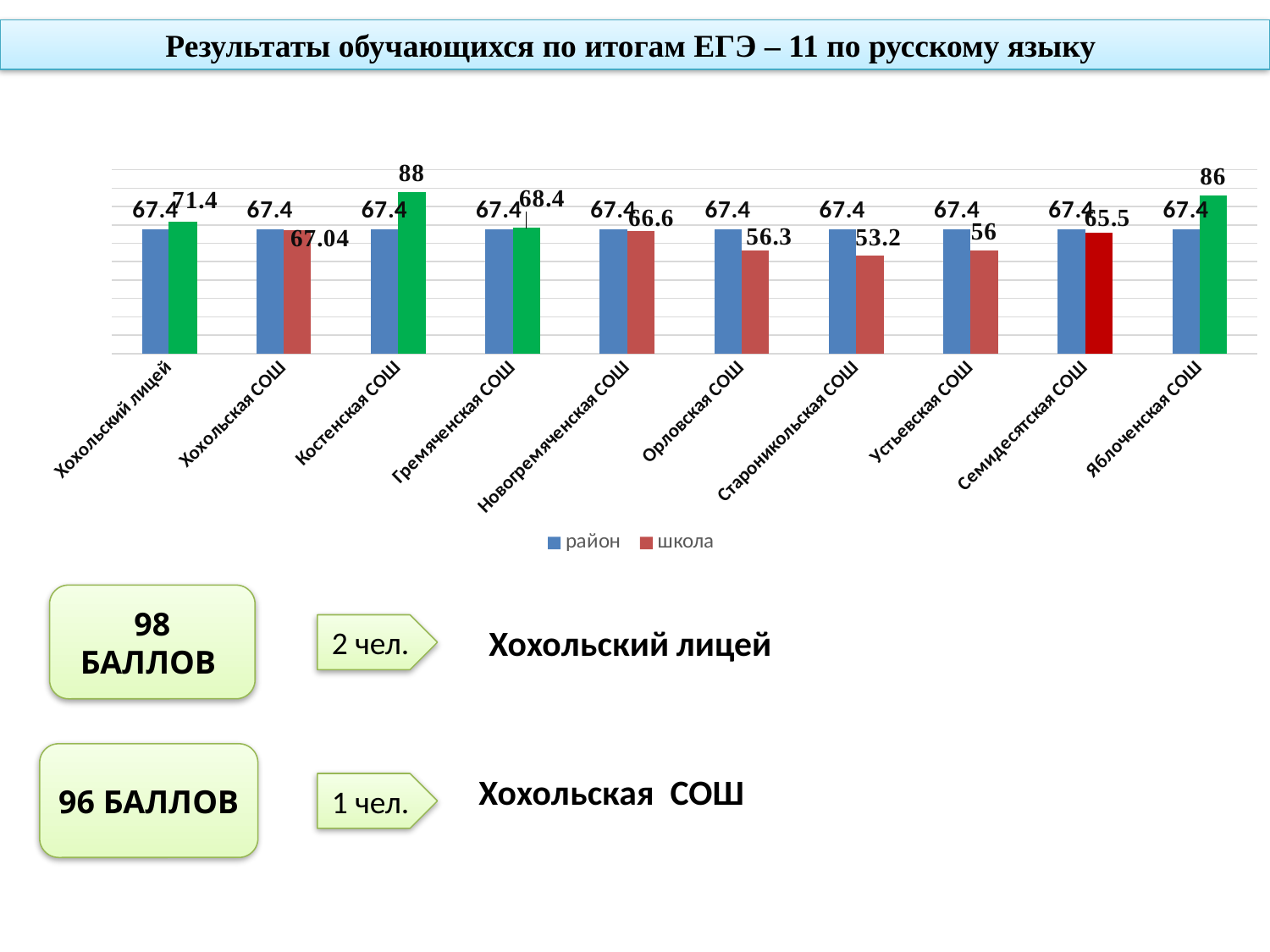
What kind of chart is shown on the slide? bar chart What is the район value for Орловская СОШ? 67.4 Which school has the lowest школа value? Староникольская СОШ What are the two series named in the chart legend? район and школа Which is larger for Орловская СОШ: the район value or the школа value? район How many series does the chart legend list? 2 What is the difference between the школа value for Яблоченская СОШ and the район value for Яблоченская СОШ? 18.6 What is the школа value for Хохольская СОШ? 67.04 What is the школа value for Костенская СОШ? 88 What is the школа value for Староникольская СОШ? 53.2 Which school has the highest школа value? Костенская СОШ How many schools are shown on the x axis of the chart? 10